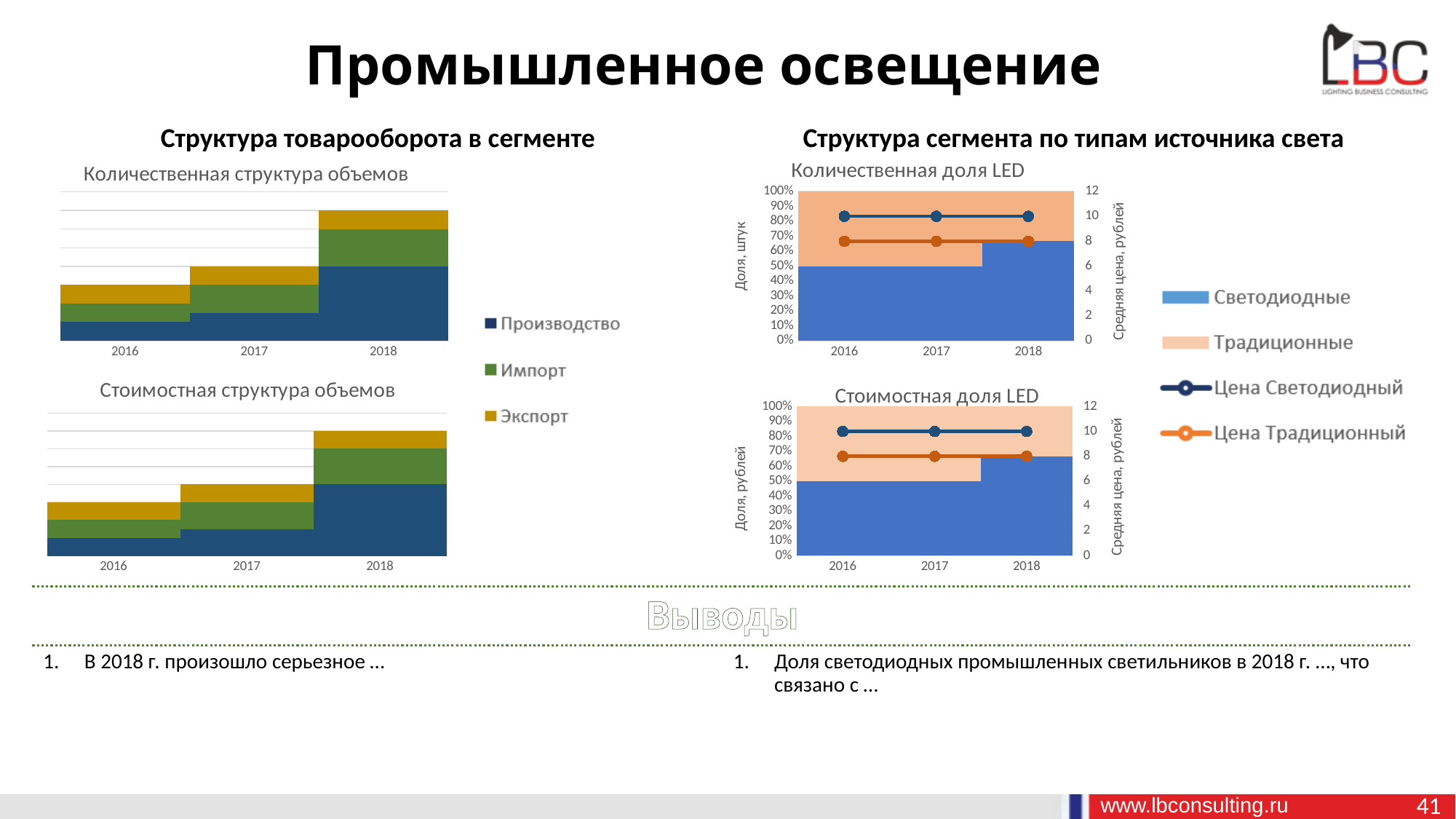
In the "Стоимостная доля LED" chart, is the LED (Светодиодные) share in 2016 greater or less than 60%? less How many entries does the legend of the "Структура сегмента по типам источника света" charts list? 4 How many series does the legend of the "Структура товарооборота в сегменте" charts list? 3 In the "Количественная доля LED" chart, is the LED (Светодиодные) share in 2018 greater or less than 60%? greater In the "Стоимостная доля LED" chart, what is the value of "Цена Традиционный" in 2018 on the right axis? 8 In the "Стоимостная структура объемов" chart, which year has the shortest stacked bar? 2016 In the "Стоимостная структура объемов" chart, which series forms the largest part of the 2018 bar? Производство What kind of chart is the "Количественная структура объемов" chart? Stacked bar chart In the "Количественная доля LED" chart, what is the value of "Цена Светодиодный" in 2017 on the right axis? 10 In the "Количественная структура объемов" chart, which year has the tallest stacked bar? 2018 In the "Количественная структура объемов" chart, do the total volumes rise or fall from 2016 to 2018? Rise How many years are shown on the x axis of the "Стоимостная структура объемов" chart? 3